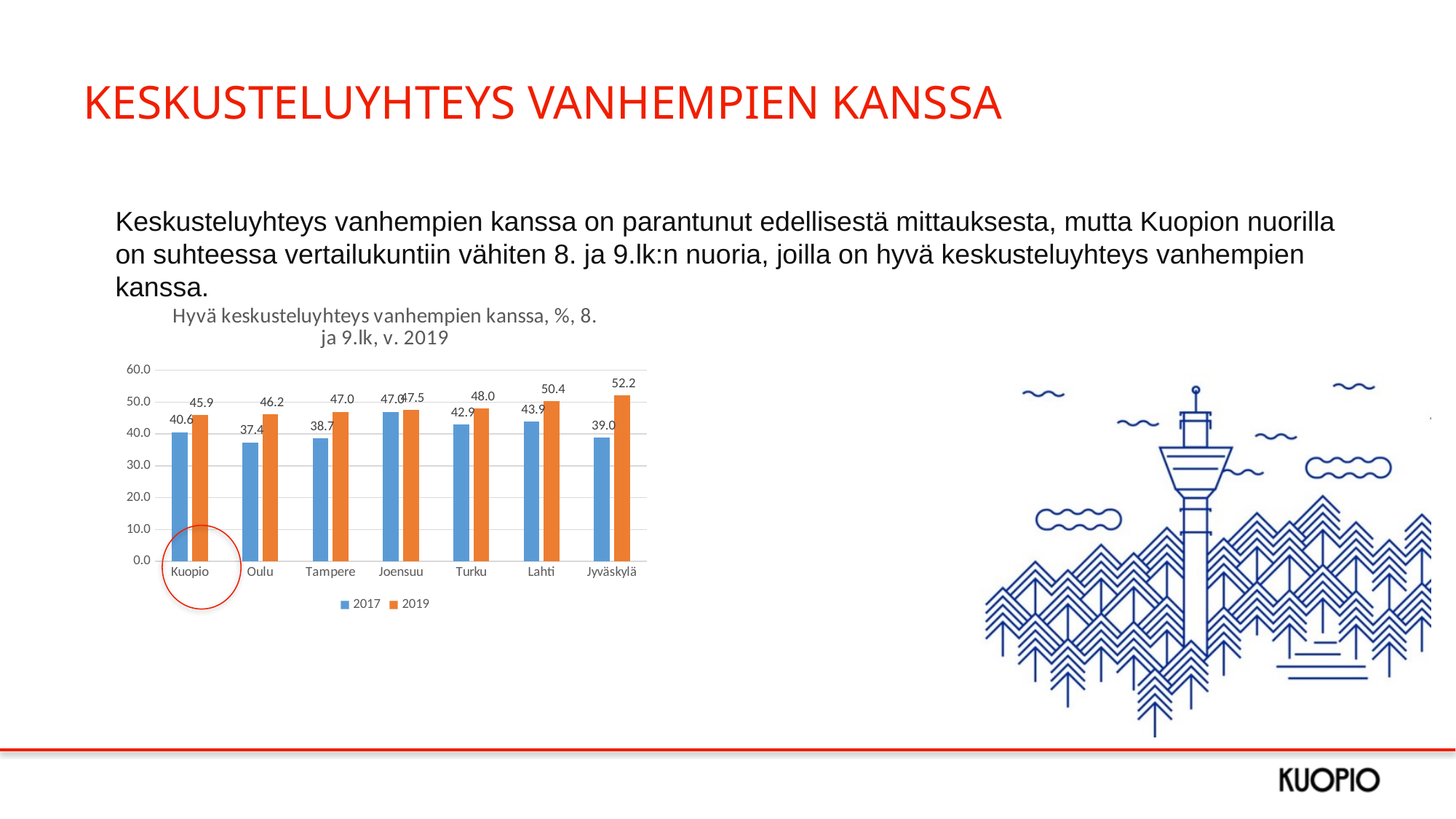
What is the 2019 value for Kuopio? 45.9 How many cities are shown on the x axis? 7 What is the 2017 value for Oulu? 37.4 Which city has the lowest 2017 value? Oulu Which is larger, the 2019 value for Turku or the 2019 value for Tampere? Turku Is the 2017 value for Joensuu greater or less than 40.0? greater What is the 2017 value for Lahti? 43.9 What is the 2019 value for Jyväskylä? 52.2 What is the difference between the 2019 and 2017 values for Jyväskylä? 13.2 What kind of chart is shown? bar chart Which city has the highest 2019 value? Jyväskylä How many series does the legend list? 2